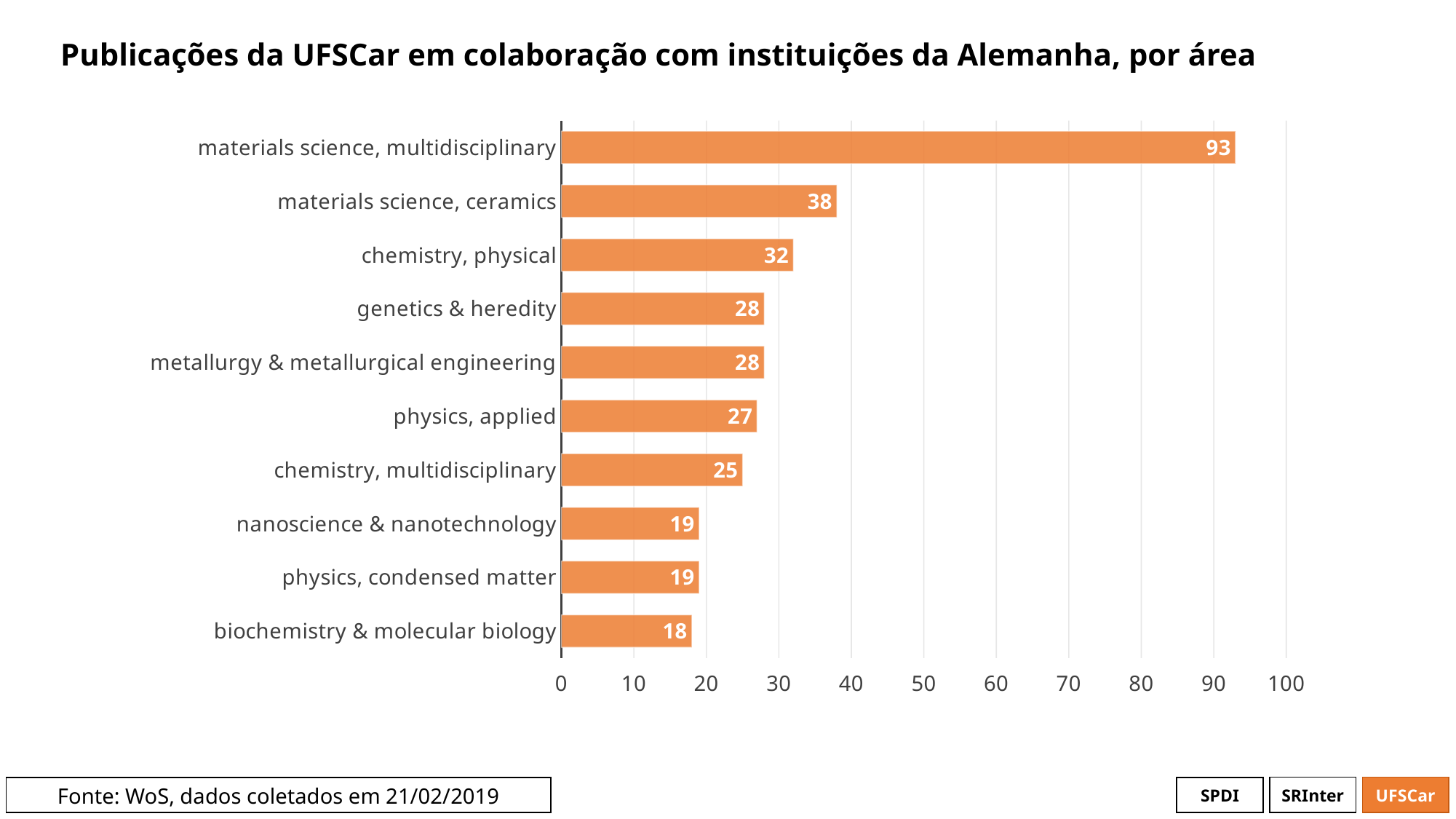
What is the difference between chemistry, physical and chemistry, multidisciplinary? 7 Is the value for materials science, ceramics greater or less than 30? greater What kind of chart is shown on the slide? bar chart What is the value for chemistry, physical? 32 What is the value for nanoscience & nanotechnology? 19 Which area has the lowest value? biochemistry & molecular biology What is the value for materials science, multidisciplinary? 93 What is the title of the chart? Publicações da UFSCar em colaboração com instituições da Alemanha, por área How many areas are shown in the chart? 10 What is the difference between materials science, multidisciplinary and materials science, ceramics? 55 Which area has the highest value? materials science, multidisciplinary Which is larger, the value for physics, applied or the value for biochemistry & molecular biology? physics, applied